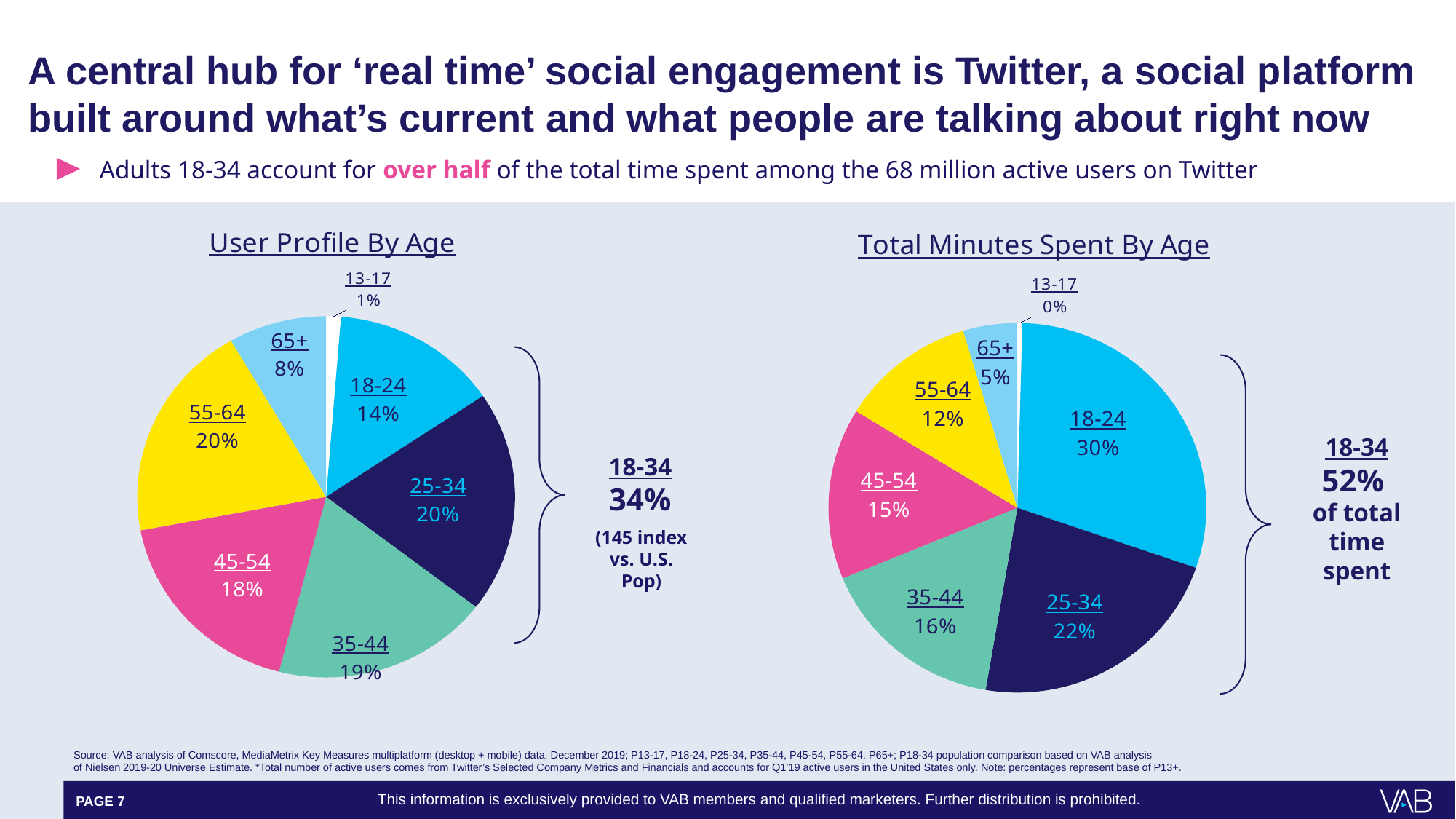
According to the bracket annotation on the 'Total Minutes Spent By Age' chart, what share of total time spent is attributed to adults 18-34? 52% In the 'Total Minutes Spent By Age' chart, what is the value for the 55-64 age group? 12% In the 'User Profile By Age' chart, what is the value for the 65+ age group? 8% In the 'User Profile By Age' chart, which is larger: the share for 45-54 or the share for 65+? 45-54 What type of chart is 'Total Minutes Spent By Age'? Pie chart In the 'Total Minutes Spent By Age' chart, which age group has the smallest share? 13-17 In the 'Total Minutes Spent By Age' chart, what share of total minutes is attributed to the 18-24 age group? 30% How many age groups are shown in the 'User Profile By Age' chart? 7 In the 'User Profile By Age' chart, which age group has the smallest share? 13-17 In the 'User Profile By Age' chart, what share of users are aged 18-24? 14% In the 'Total Minutes Spent By Age' chart, what is the difference between the 18-24 share and the 25-34 share? 8 percentage points In the 'Total Minutes Spent By Age' chart, which age group has the largest share? 18-24